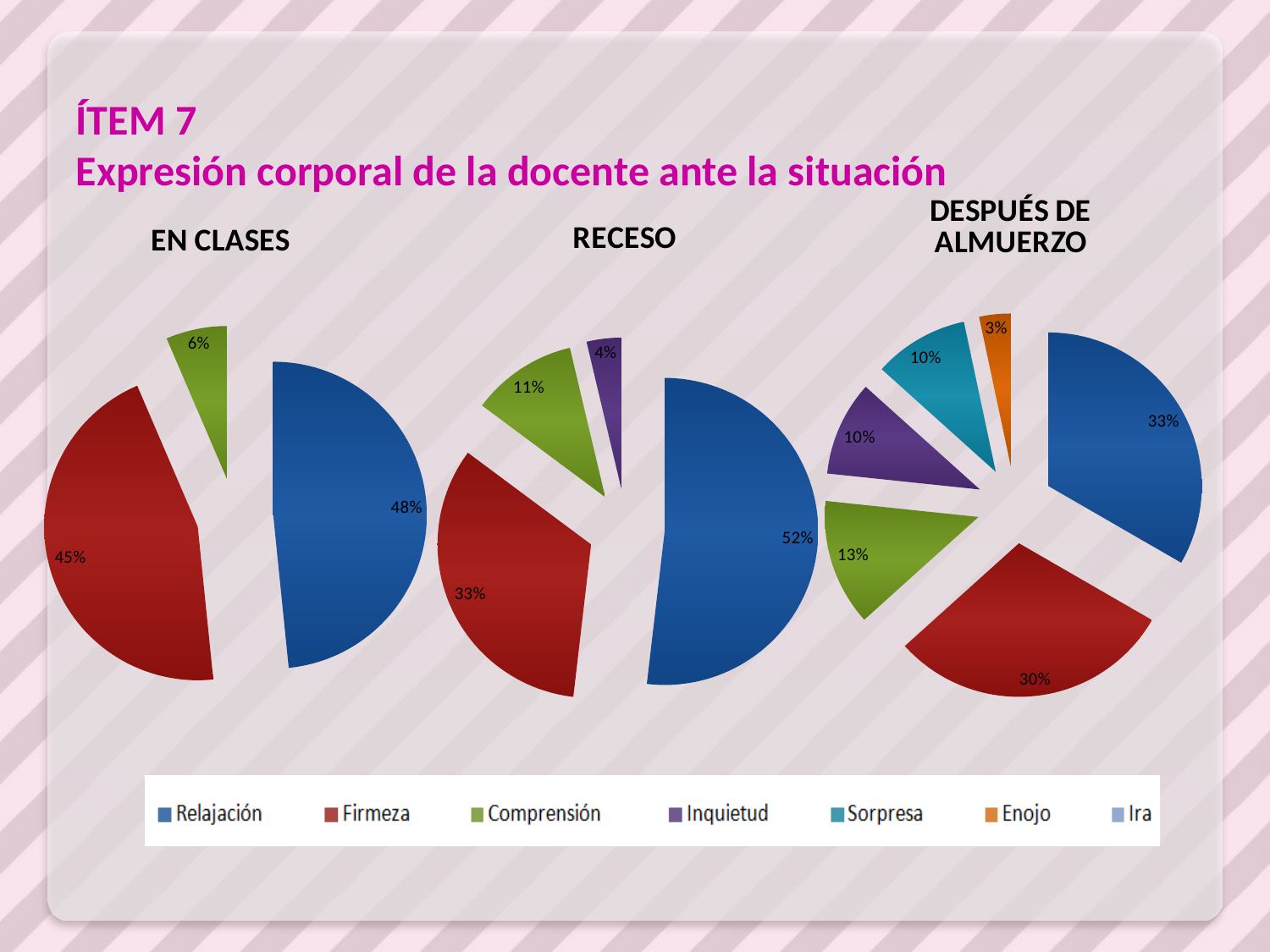
How many slices does the DESPUÉS DE ALMUERZO pie chart have? 6 In the DESPUÉS DE ALMUERZO pie chart, which is larger, Comprensión or Sorpresa? Comprensión In the EN CLASES pie chart, what share does Relajación have? 48% In the EN CLASES pie chart, which category has the smallest slice? Comprensión What kind of chart is used for EN CLASES, RECESO and DESPUÉS DE ALMUERZO? Pie chart In the DESPUÉS DE ALMUERZO pie chart, what share does Enojo have? 3% How many entries does the shared legend list? 7 In the RECESO pie chart, what is the difference between the Relajación and Firmeza shares? 19% In the EN CLASES pie chart, what share does Firmeza have? 45% In the RECESO pie chart, what share does Inquietud have? 4% In the DESPUÉS DE ALMUERZO pie chart, which category has the largest slice? Relajación